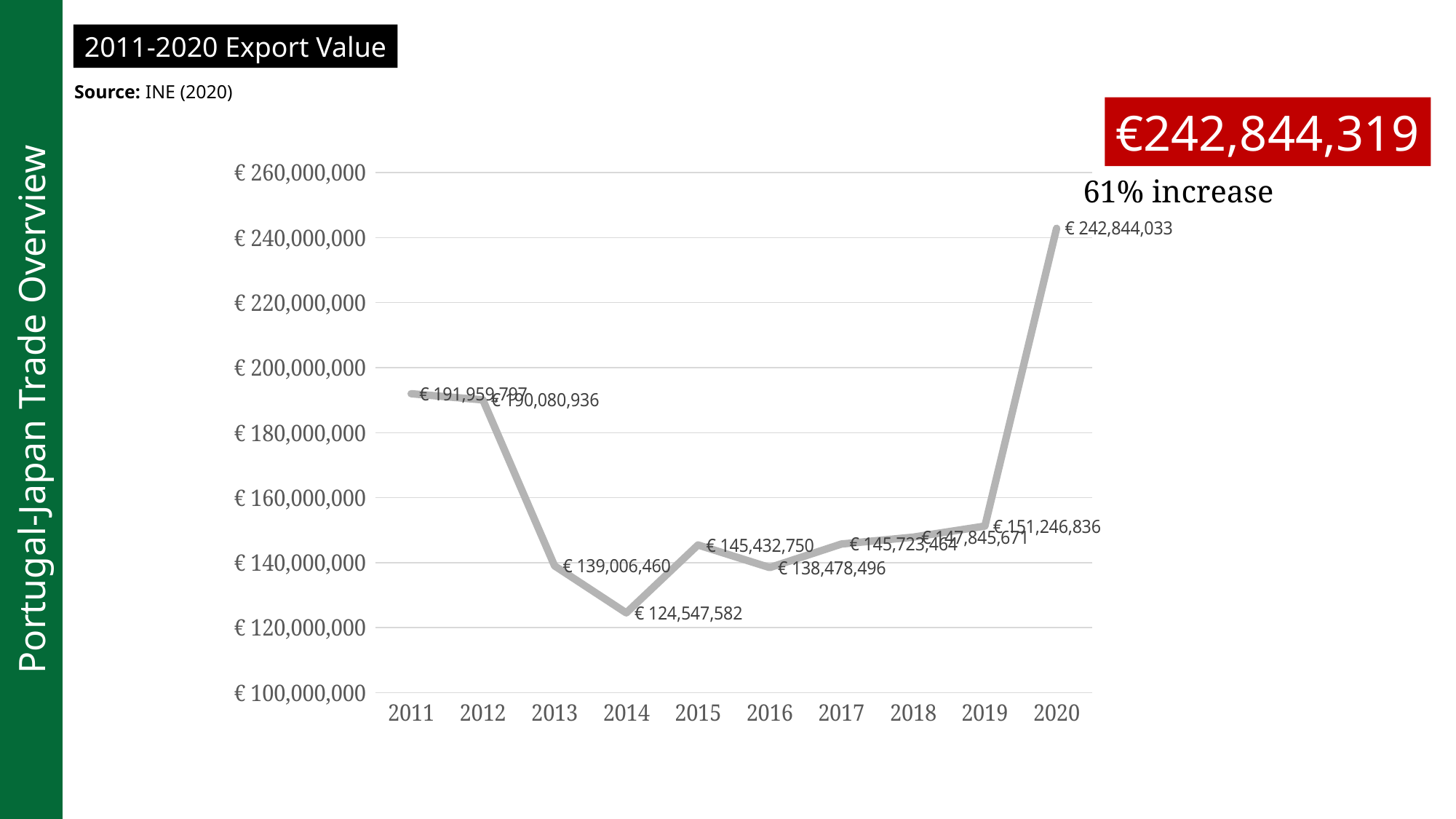
What is the title of the chart? 2011-2020 Export Value Which year has the larger export value, 2015 or 2016? 2015 Is the export value for 2012 greater or less than € 180,000,000? greater What is the export value for 2019? € 151,246,836 What kind of chart is shown on the slide? Line chart What is the difference between the export value in 2020 and in 2019? € 91,597,197 Which year has the lowest export value? 2014 What is the export value for 2020? € 242,844,033 What is the export value for 2014? € 124,547,582 What is the export value for 2013? € 139,006,460 How many years are plotted on the x axis of the chart? 10 Which year has the highest export value? 2020